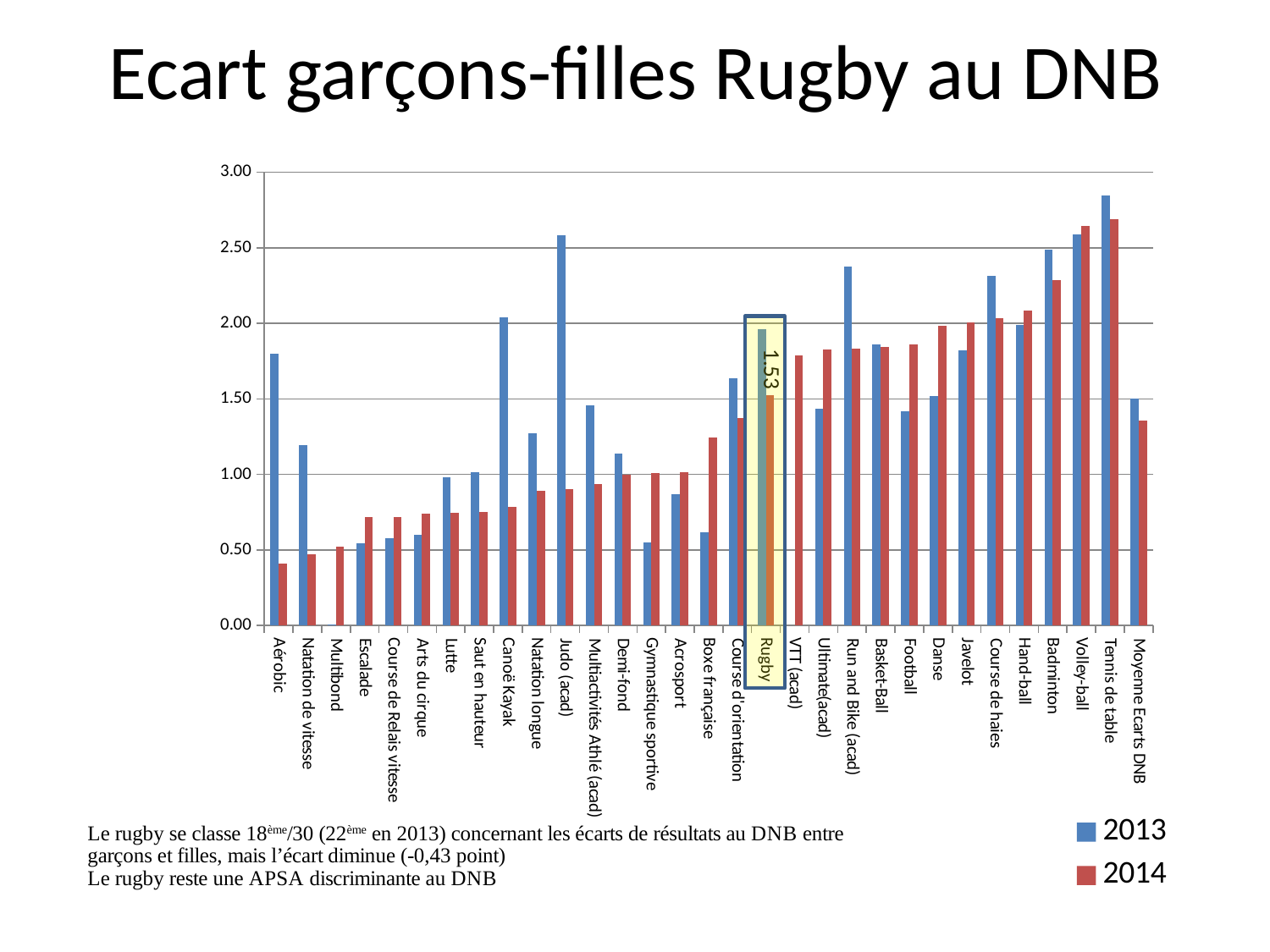
Is the 2013 value for Boxe française greater or less than 1.00? less What is the 2014 value for Rugby? 1.53 Which category has the highest 2013 value? Tennis de table Is the 2013 value for Run and Bike (acad) greater or less than 2.00? greater How many series does the legend list? 2 Is the 2013 value for Judo (acad) greater or less than 2.50? greater How many categories are shown on the x axis? 31 For Judo (acad), which series has the larger value, 2013 or 2014? 2013 For Danse, which series has the larger value, 2013 or 2014? 2014 What kind of chart is shown on the slide? bar chart What is the title of the chart? Ecart garçons-filles Rugby au DNB